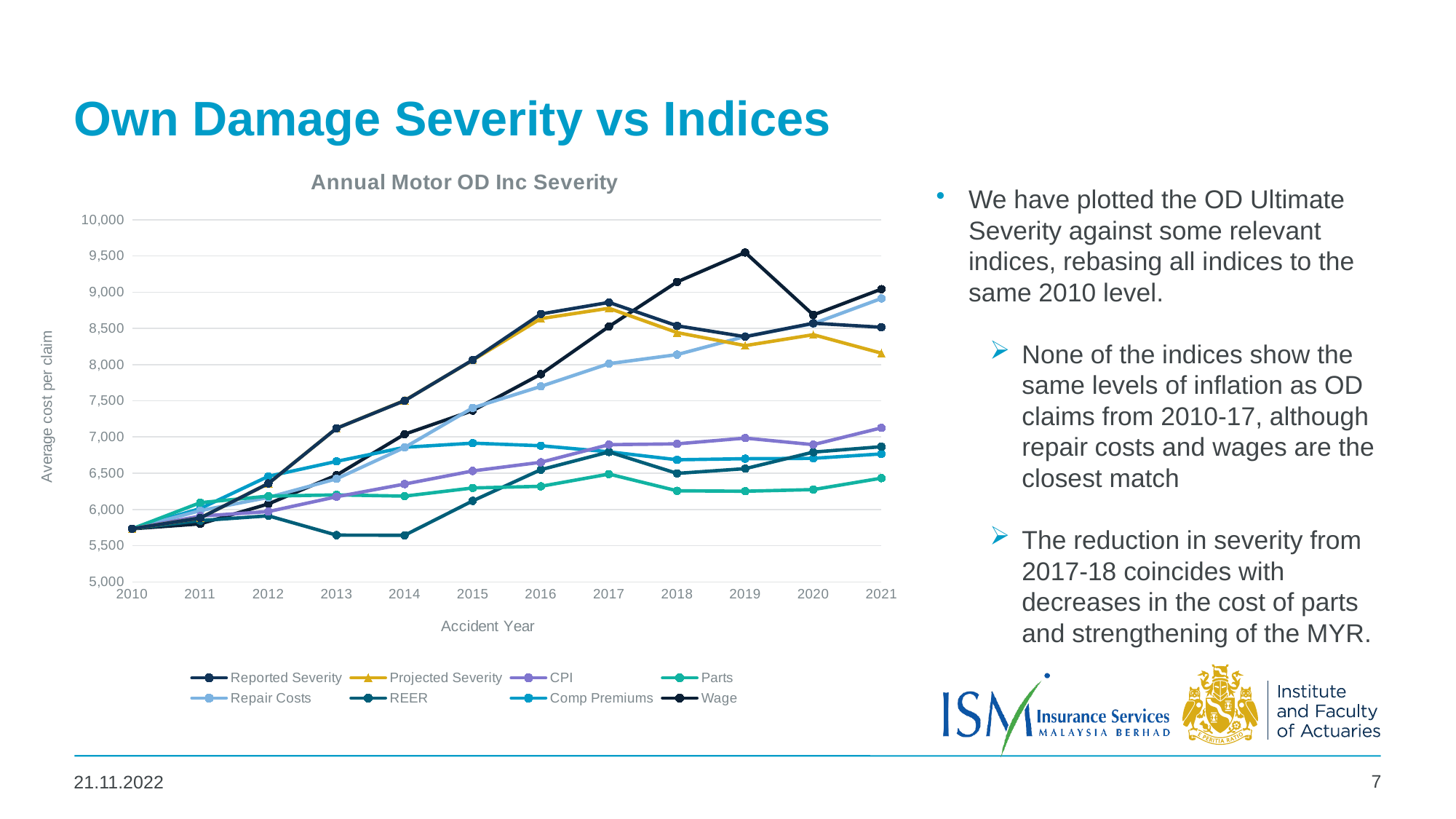
How many series does the legend of the chart list? 8 Does the Repair Costs series generally rise or fall from 2010 to 2021? rise Is the value for Wage in 2019 greater or less than 9,000? greater Which series has the highest value in 2019? Wage Is the value for Parts in 2021 greater or less than 7,000? less In 2021, which is larger: Wage or Projected Severity? Wage Which series has the lowest value in 2013? REER What is the title of the chart? Annual Motor OD Inc Severity How many accident years are plotted along the x axis of the chart? 12 What kind of chart is shown on the slide? Line chart Is the value for Repair Costs in 2021 greater or less than 8,500? greater What is the label of the y axis of the chart? Average cost per claim